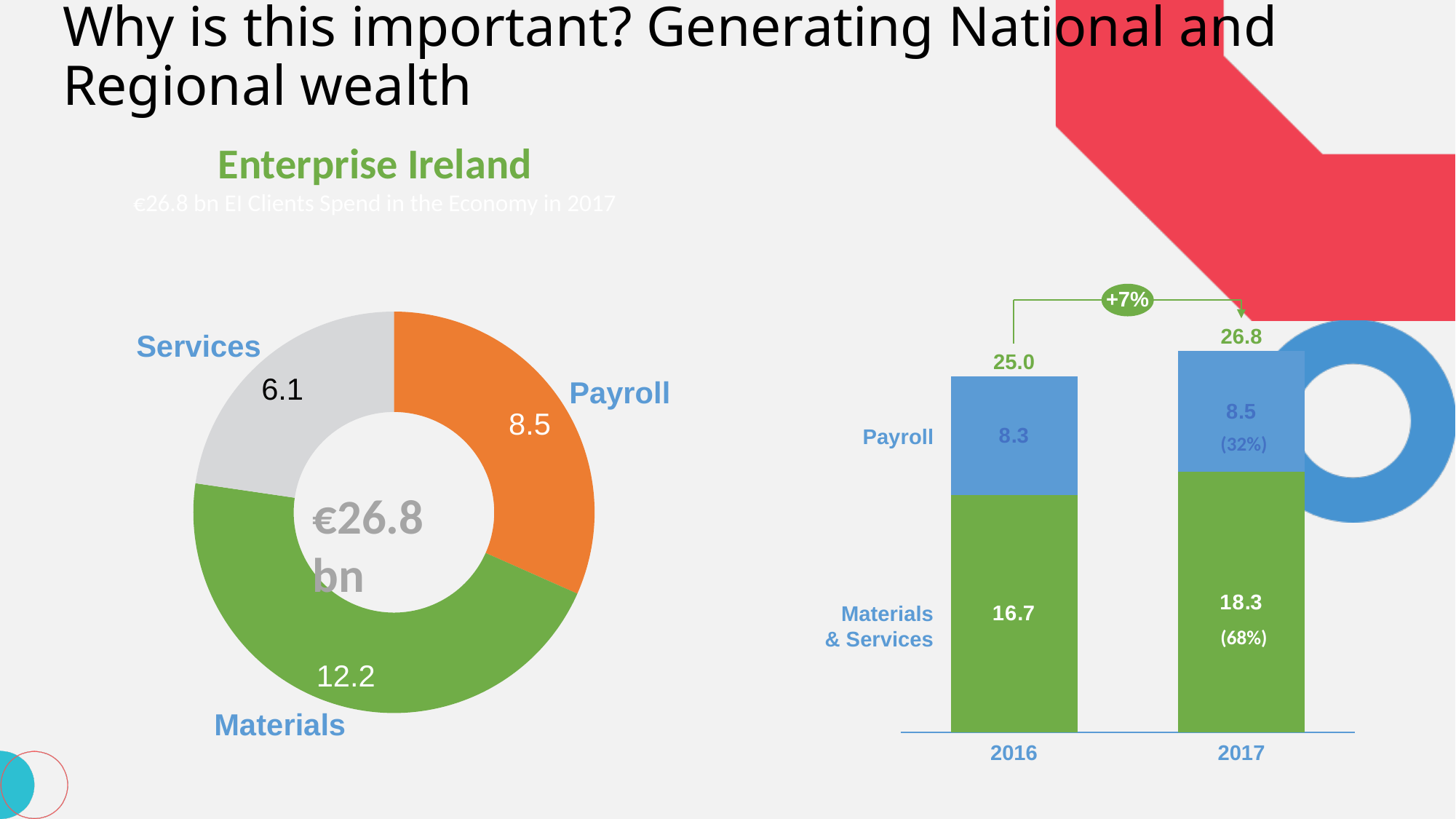
In the donut chart on the left, what is the value for Payroll? 8.5 In the donut chart on the left, what total is shown in the centre? €26.8 bn In the stacked bar chart on the right, what is the difference in Materials & Services between 2017 and 2016? 1.6 In the stacked bar chart on the right, what is the Materials & Services value for 2017? 18.3 In the stacked bar chart on the right, what percentage change is shown between 2016 and 2017? +7% In the donut chart on the left, what is the difference between Materials and Services? 6.1 In the stacked bar chart on the right, what is the total of the 2017 bar? 26.8 In the donut chart on the left, which category has the smallest value? Services In the donut chart on the left, what is the value for Services? 6.1 In the donut chart on the left, how many categories are shown? 3 In the donut chart on the left, which category has the largest value? Materials In the stacked bar chart on the right, what is the Payroll value for 2016? 8.3